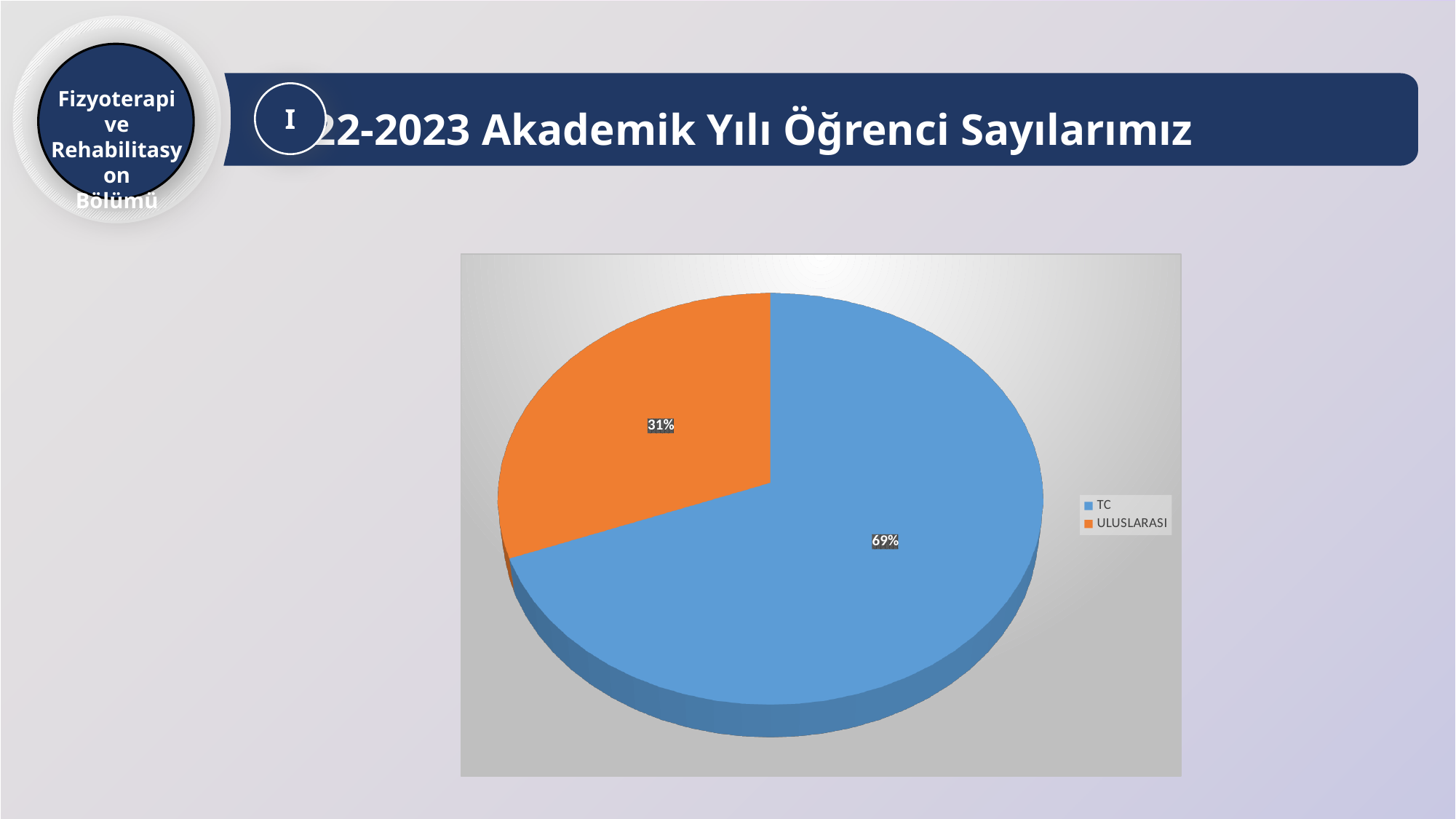
What colour is the TC slice? blue What kind of chart is shown on the slide? pie chart Which category has the largest slice of the pie? TC What is the difference in percentage points between the TC and ULUSLARASI slices? 38 Which slice is larger, TC or ULUSLARASI? TC What colour is the ULUSLARASI slice? orange What share of the pie does the TC slice represent? 69% Which category has the smallest slice of the pie? ULUSLARASI How many entries does the legend list? 2 What share of the pie does the ULUSLARASI slice represent? 31% How many slices does the pie chart have? 2